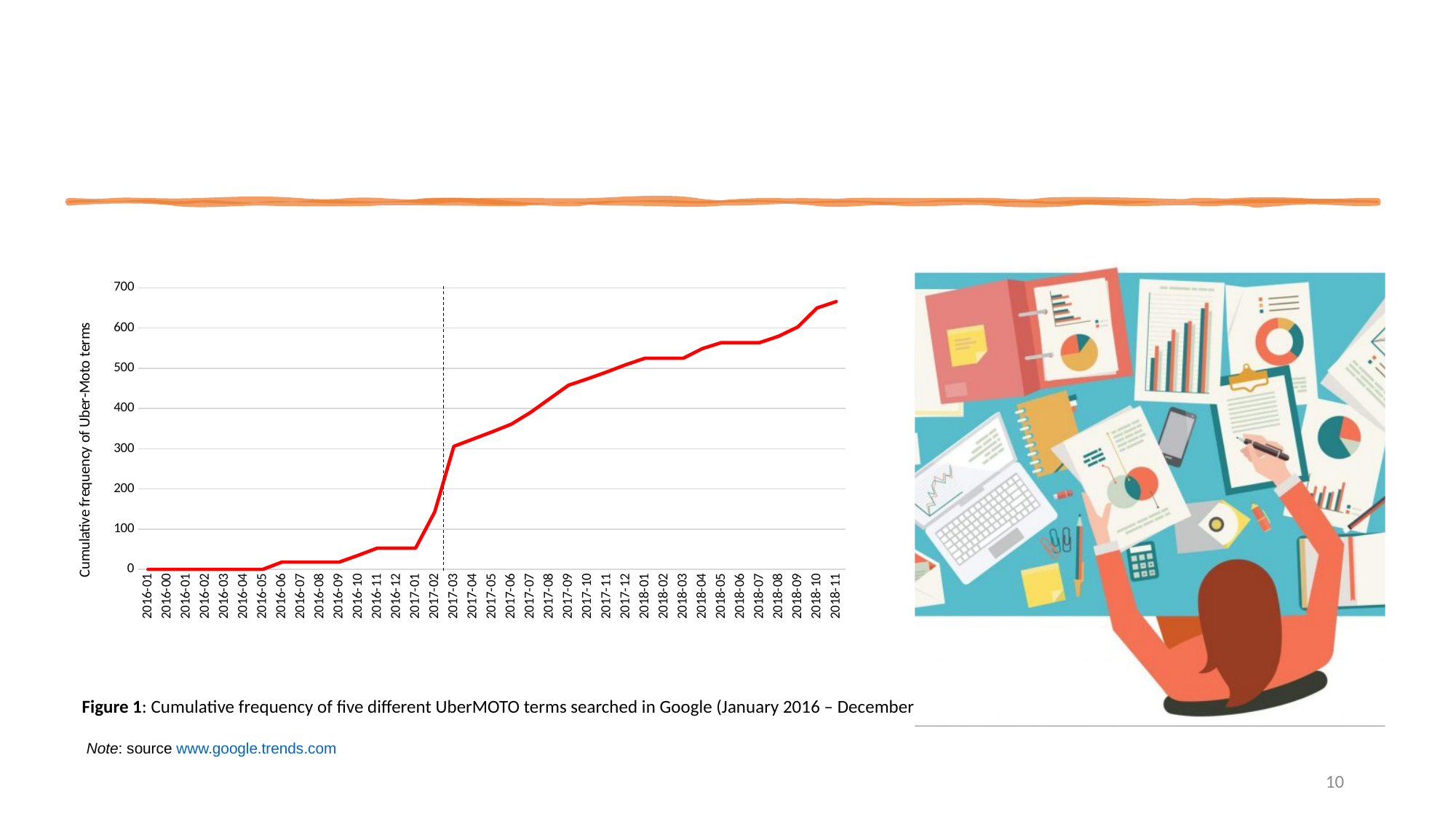
What colour is the plotted line in the chart? red Is the value for 2017-06 greater or less than 400? less What is the label of the y axis of the chart? Cumulative frequency of Uber-Moto terms Is the value for 2017-09 greater or less than 400? greater Is the value for 2018-11 greater or less than 600? greater What kind of chart is shown on the slide? line chart Which x-axis label has the highest value in the chart? 2018-11 What is the value plotted for 2016-01 in the chart? 0 Do the values in the chart rise or fall along the x axis from 2016-01 to 2018-11? rise Which has the larger value, 2017-03 or 2018-03? 2018-03